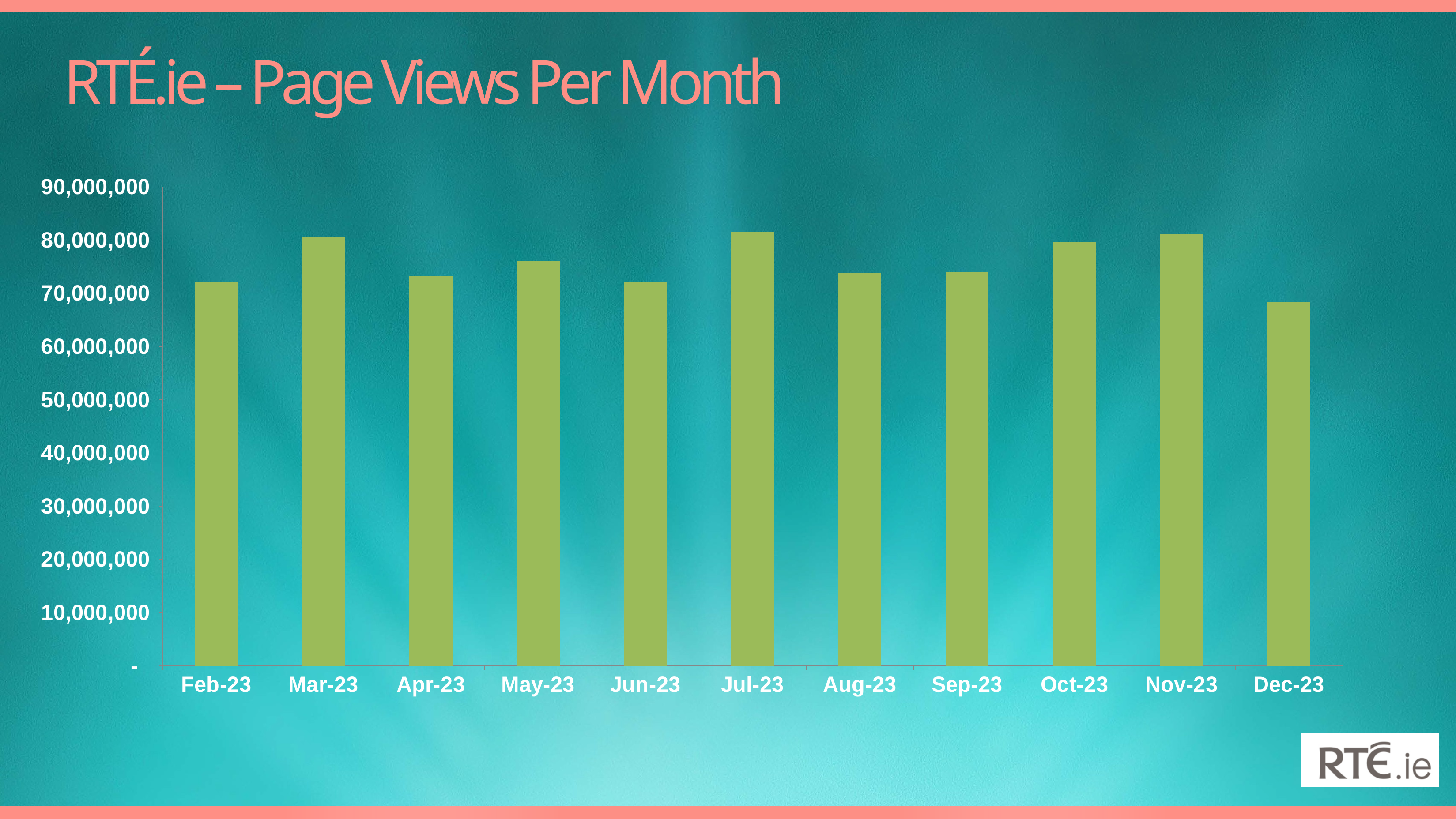
What kind of chart is shown on the slide? bar chart Which is larger, the value for Jun-23 or the value for Dec-23? Jun-23 Which is larger, the value for May-23 or the value for Apr-23? May-23 What is the title of the chart? RTÉ.ie – Page Views Per Month Is the value for Dec-23 greater or less than 60,000,000? greater Which month has the lowest page views? Dec-23 Do page views rise or fall from Nov-23 to Dec-23? fall How many months are plotted on the chart? 11 Is the value for Jul-23 greater or less than 80,000,000? greater Is the value for May-23 greater or less than 70,000,000? greater Which is larger, the value for Mar-23 or the value for Feb-23? Mar-23